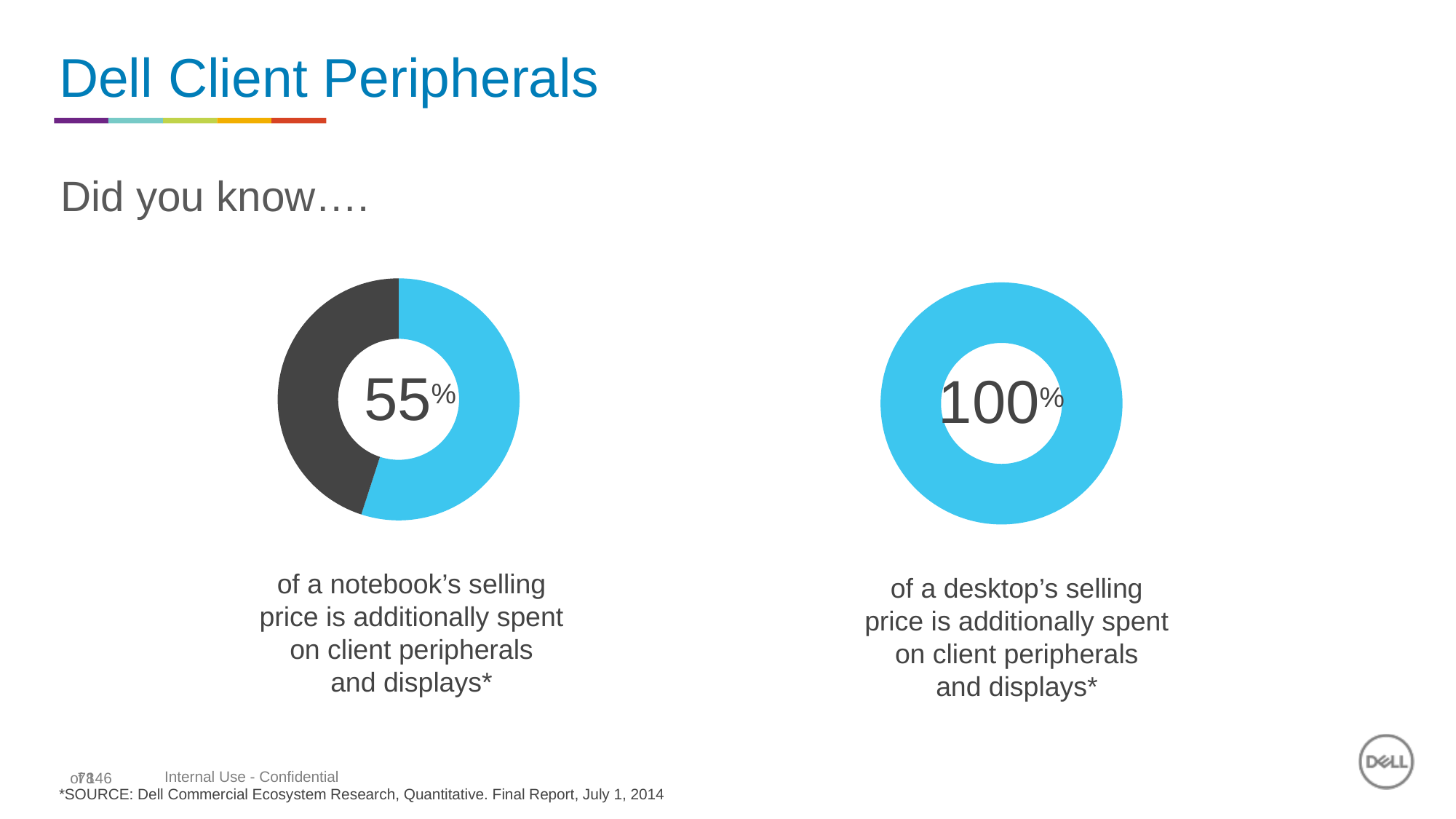
On the right chart, what share of the donut is filled in blue? 100% Which product's chart shows the lower percentage spent on client peripherals and displays, notebook or desktop? notebook What kind of chart is used on the left of the slide to show the notebook percentage? donut (pie) chart Which is larger: the percentage shown for notebooks (left chart) or for desktops (right chart)? desktops On the left chart, is the blue portion greater or less than 50% of the donut? greater On the right chart, what percentage of a desktop's selling price is additionally spent on client peripherals and displays? 100% On the left chart, what share of the donut is filled in blue? 55% What colour is used for the filled portion of both donut charts? blue What is the title of the slide containing the two donut charts? Dell Client Peripherals What is the difference in percentage points between the desktop value (right chart) and the notebook value (left chart)? 45 How many donut charts are shown on the slide? 2 On the left chart, what percentage of a notebook's selling price is additionally spent on client peripherals and displays? 55%